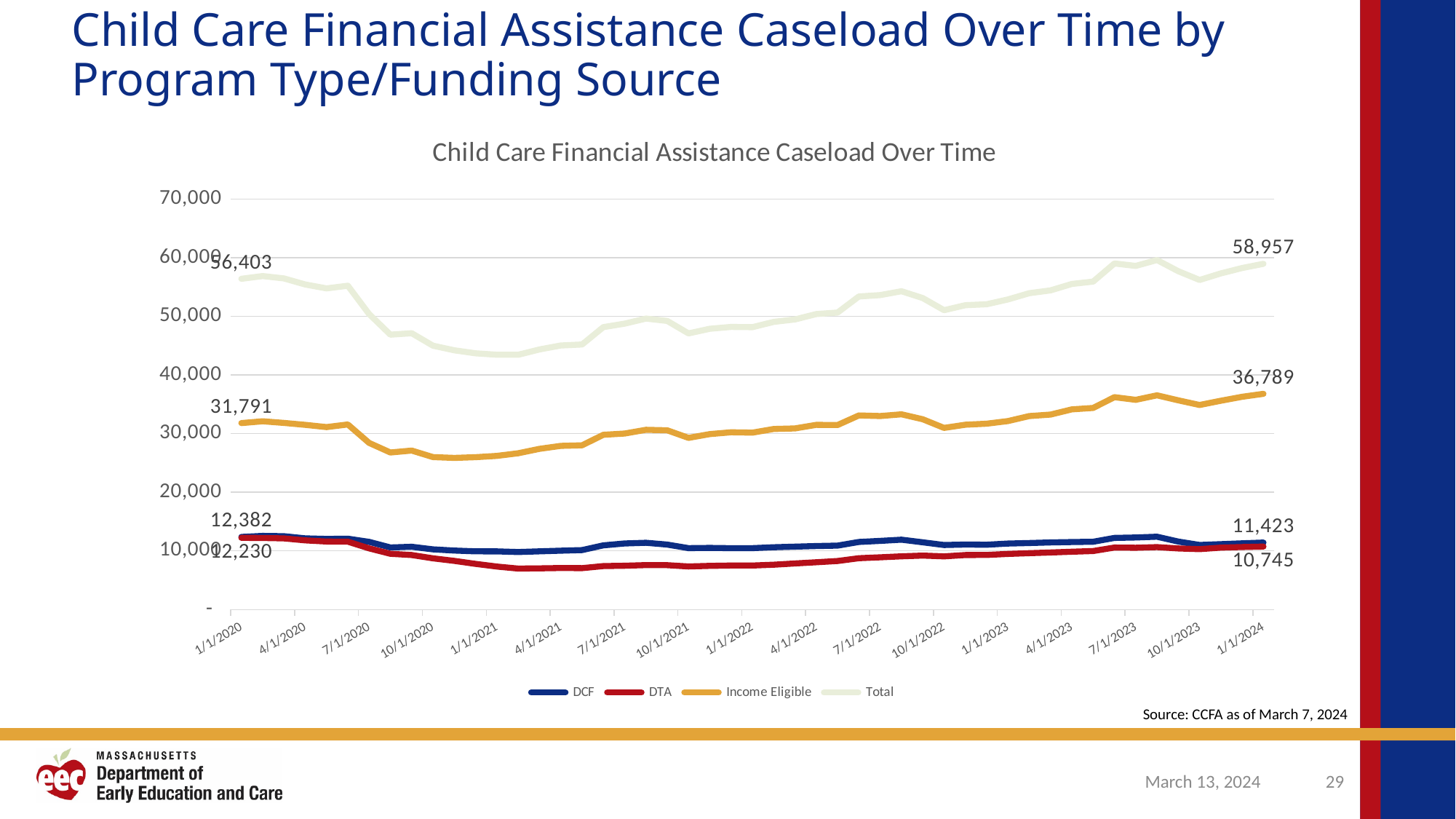
Which series has the highest value at 1/1/2024? Total How many series does the legend list? 4 Does the Income Eligible series rise or fall between 1/1/2021 and 1/1/2024? Rise What is the value of the Total series at 1/1/2024? 58,957 What is the value of the DCF series at 1/1/2024? 11,423 Which series has the lowest value at 1/1/2024? DTA What is the value of the Income Eligible series at 1/1/2020? 31,791 Is the Total value at 1/1/2021 greater or less than 50,000? less What kind of chart is shown on the slide? Line chart What is the difference between the DCF value (11,423) and the DTA value (10,745) at 1/1/2024? 678 By how much did the Income Eligible caseload change from 1/1/2020 (31,791) to 1/1/2024 (36,789)? 4,998 What is the value of the DTA series at 1/1/2024? 10,745